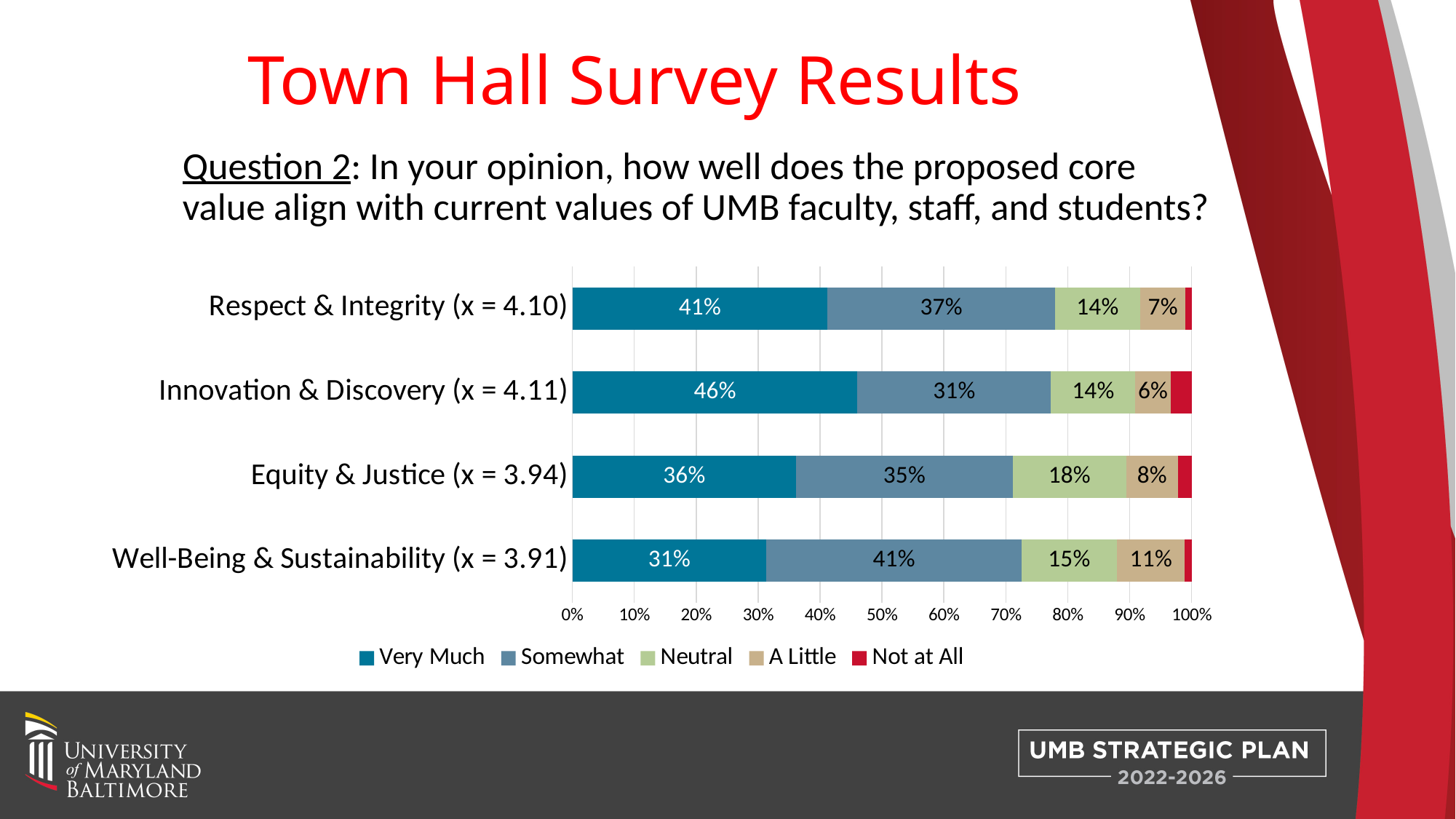
How many response categories does the legend list? 5 Which has a larger "Somewhat" value: Respect & Integrity or Equity & Justice? Respect & Integrity What type of chart is shown on the slide? Stacked bar chart Which core value has the highest "Very Much" percentage? Innovation & Discovery How many percentage points higher is the "Very Much" value for Innovation & Discovery than for Well-Being & Sustainability? 15 percentage points What is the "Neutral" percentage for Equity & Justice? 18% What is the "Somewhat" value for Well-Being & Sustainability? 41% Which core value has the lowest "Very Much" percentage? Well-Being & Sustainability What percentage of respondents answered "Very Much" for Innovation & Discovery? 46% How many core values are shown in the chart? 4 What is the "A Little" value for Well-Being & Sustainability? 11% Is the "Not at All" value for Innovation & Discovery greater or less than 10%? less